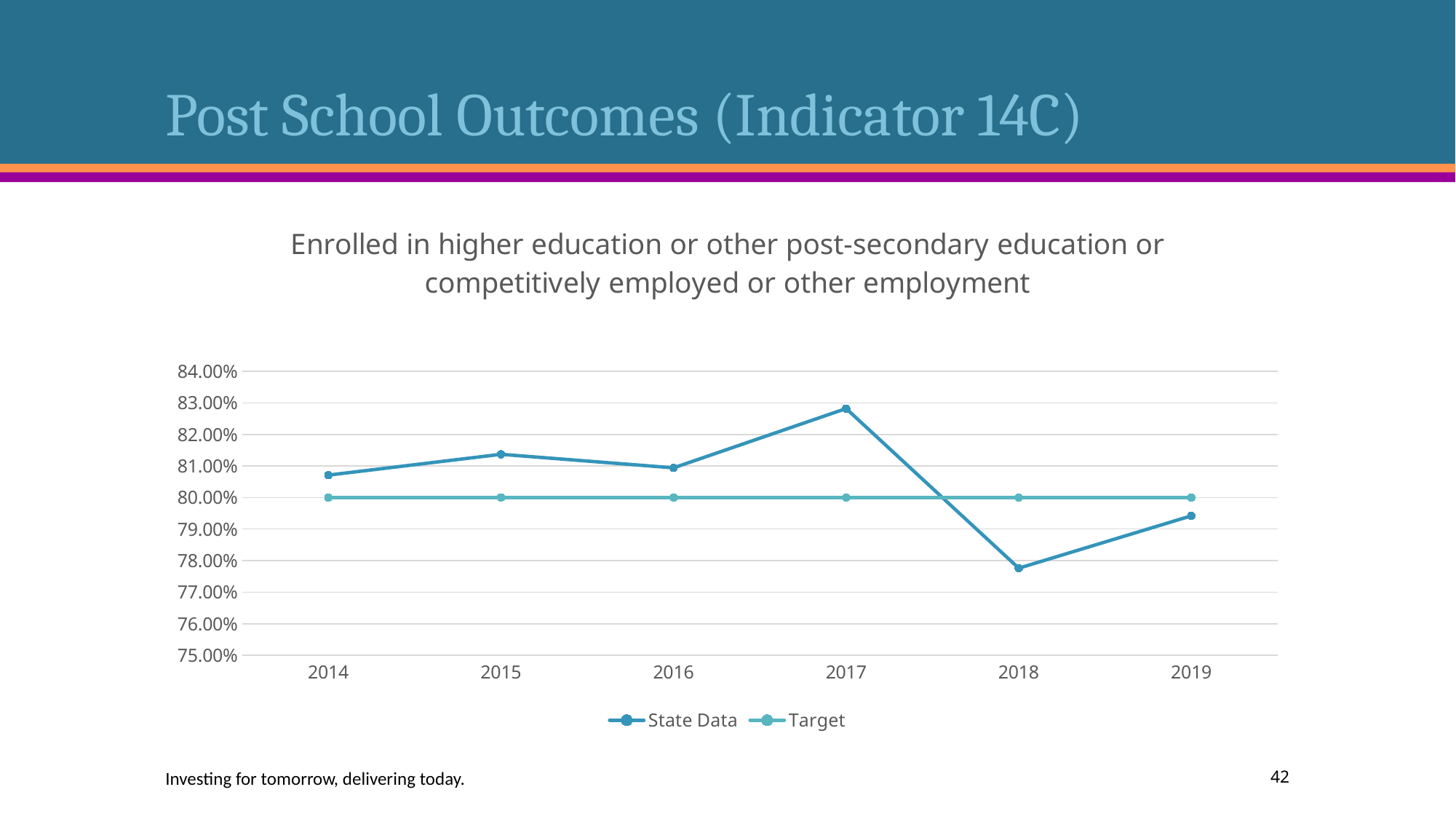
Which year has the larger State Data value, 2015 or 2016? 2015 Is the State Data value for 2018 greater or less than 79.00%? less Is the State Data value for 2014 greater or less than 80.00%? greater What kind of chart is shown on the slide? line chart Is the State Data value for 2017 greater or less than 82.00%? greater How many series does the legend list? 2 In which year is the State Data value lowest? 2018 Does the State Data line rise or fall from 2017 to 2018? fall How many years are plotted along the x axis? 6 What are the two series named in the legend? State Data and Target In which year is the State Data value highest? 2017 What is the Target value in 2016? 80.00%